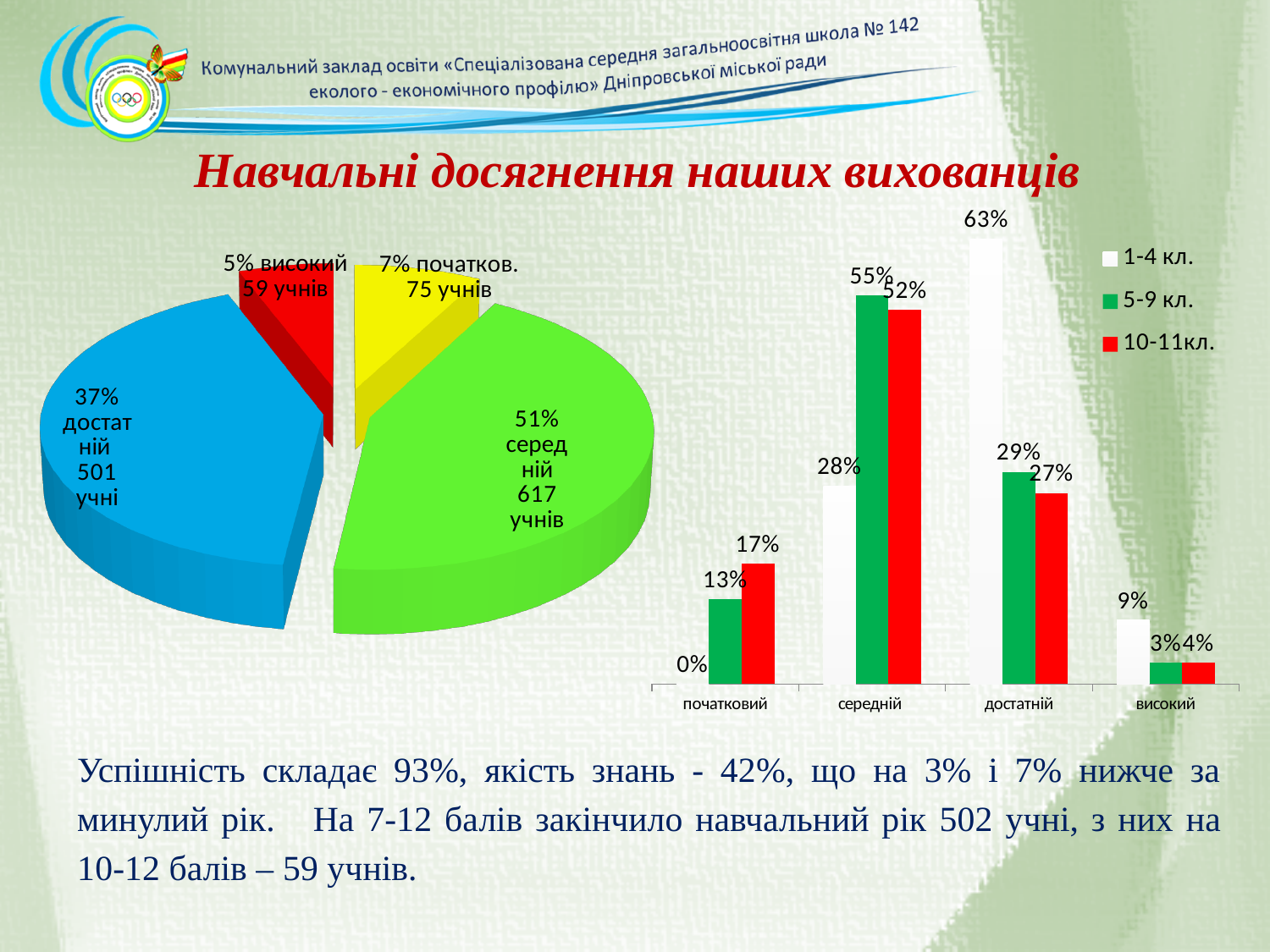
In the bar chart on the right, what colour represents the 10-11кл. series? red In the pie chart on the left, how many slices are there? 4 What type of chart is on the right side of the slide? bar chart In the pie chart on the left, what percentage is shown for the середній slice? 51% In the bar chart on the right, which category has the highest value for 5-9 кл.? середній In the bar chart on the right, how many series does the legend list? 3 In the bar chart on the right, what is the value for 1-4 кл. in the достатній category? 63% In the bar chart on the right, what is the difference between the 5-9 кл. and 10-11кл. values in the середній category? 3% In the bar chart on the right, which is larger in the високий category: 1-4 кл. or 5-9 кл.? 1-4 кл. In the pie chart on the left, which category has the smallest share? високий In the pie chart on the left, how many students (учнів) are in the достатній slice? 501 In the bar chart on the right, what is the value for 10-11кл. in the початковий category? 17%